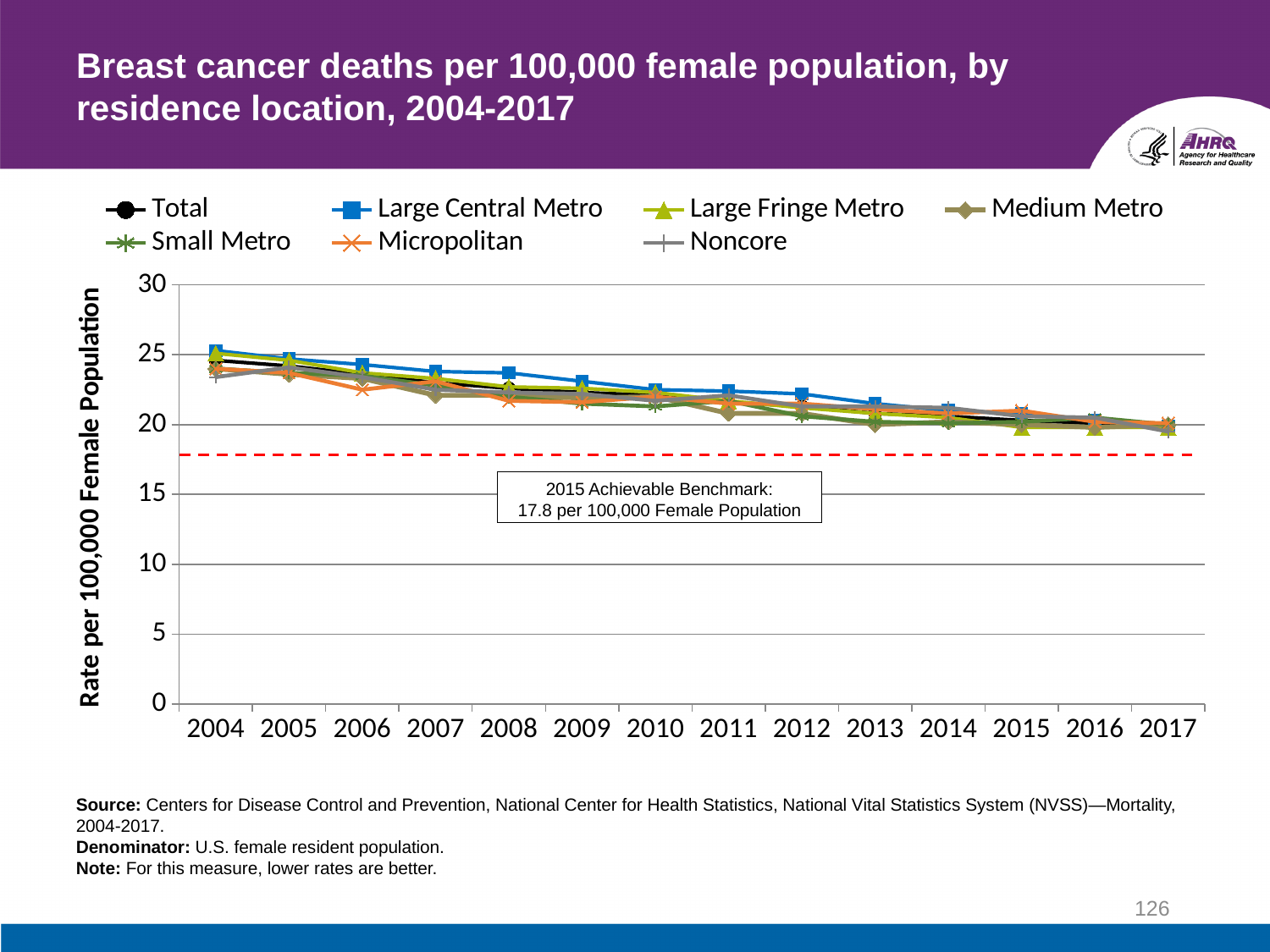
Which series has the highest value in 2009? Large Central Metro Is the value for Total in 2017 greater or less than 25? less Do the breast cancer death rates generally rise or fall from 2004 to 2017? fall What is the 2015 Achievable Benchmark shown on the chart? 17.8 per 100,000 Female Population What is the title of the chart? Breast cancer deaths per 100,000 female population, by residence location, 2004-2017 What kind of chart is shown on the slide? line chart What is the label of the y axis? Rate per 100,000 Female Population How many series does the legend list? 7 In 2006, which is larger: Large Central Metro or Micropolitan? Large Central Metro Is the value for Micropolitan in 2006 greater or less than 25? less How many years are shown along the x axis? 14 Is the value for Large Central Metro in 2004 greater or less than 20? greater